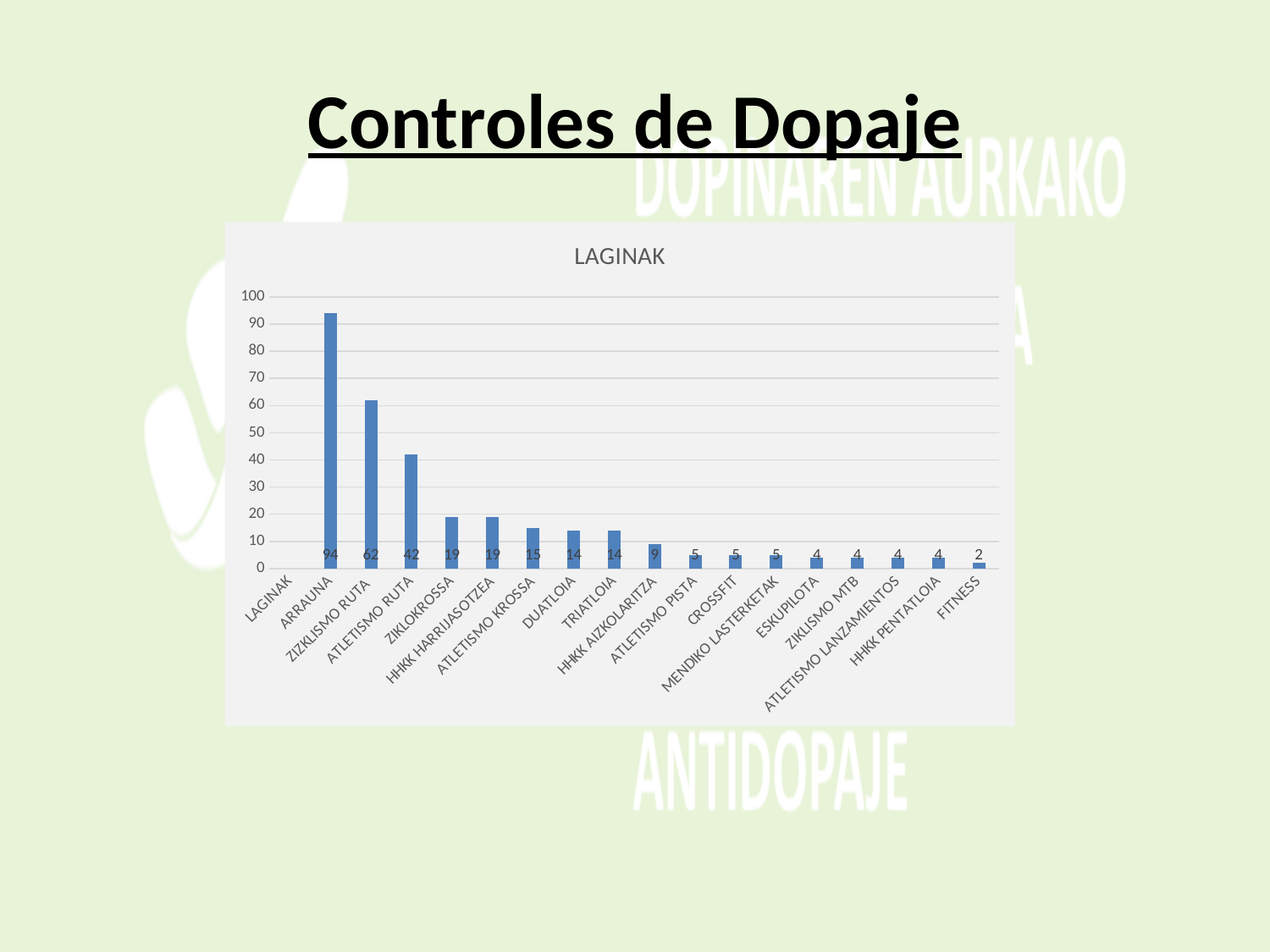
What is the value for HHKK AIZKOLARITZA? 9 Which category has the lowest value in the chart? FITNESS What is the value for ARRAUNA in the LAGINAK chart? 94 Which is larger, the value for ZIKLOKROSSA or the value for ATLETISMO KROSSA? ZIKLOKROSSA Is the value for ZIZKLISMO RUTA greater or less than 50? greater What kind of chart is shown on the slide? Bar chart Which category has the highest value in the chart? ARRAUNA What is the title of the chart? LAGINAK What is the difference between the values for ARRAUNA and ZIZKLISMO RUTA? 32 What is the value for FITNESS in the LAGINAK chart? 2 Do the values rise or fall moving from left to right along the x axis? Fall What is the value for ATLETISMO RUTA? 42